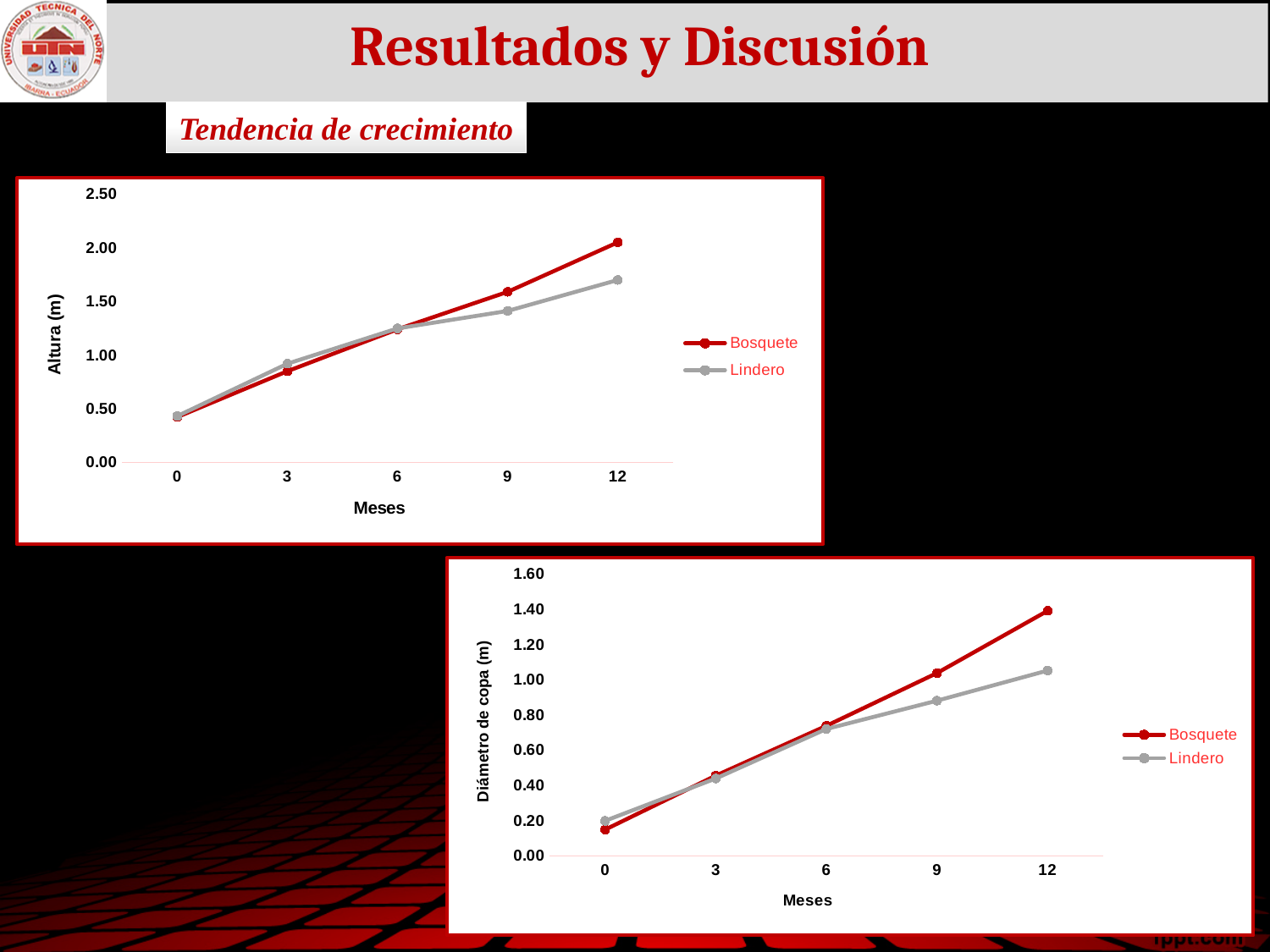
In the bottom chart (Diámetro de copa (m)), is the Bosquete value at 0 months greater or less than 0.20? less What kind of chart is the top chart (Altura (m) vs Meses)? line chart In the top chart (Altura (m)), is the Lindero value at 12 months greater or less than 1.50? greater In the top chart (Altura (m)), does the Lindero series rise or fall as Meses increases from 0 to 12? rise In the bottom chart (Diámetro de copa (m)), which series has the larger value at 12 months, Bosquete or Lindero? Bosquete In the top chart (Altura (m)), which series has the larger value at 12 months, Bosquete or Lindero? Bosquete In the bottom chart (Diámetro de copa (m)), does the Bosquete series rise or fall as Meses increases? rise What is the label of the x axis on the bottom chart (Diámetro de copa (m))? Meses How many series does the legend of the bottom chart (Diámetro de copa (m)) list? 2 In the top chart (Altura (m)), is the Bosquete value at 0 months greater or less than 0.50? less In the top chart (Altura (m)), how many points are plotted for the Bosquete series? 5